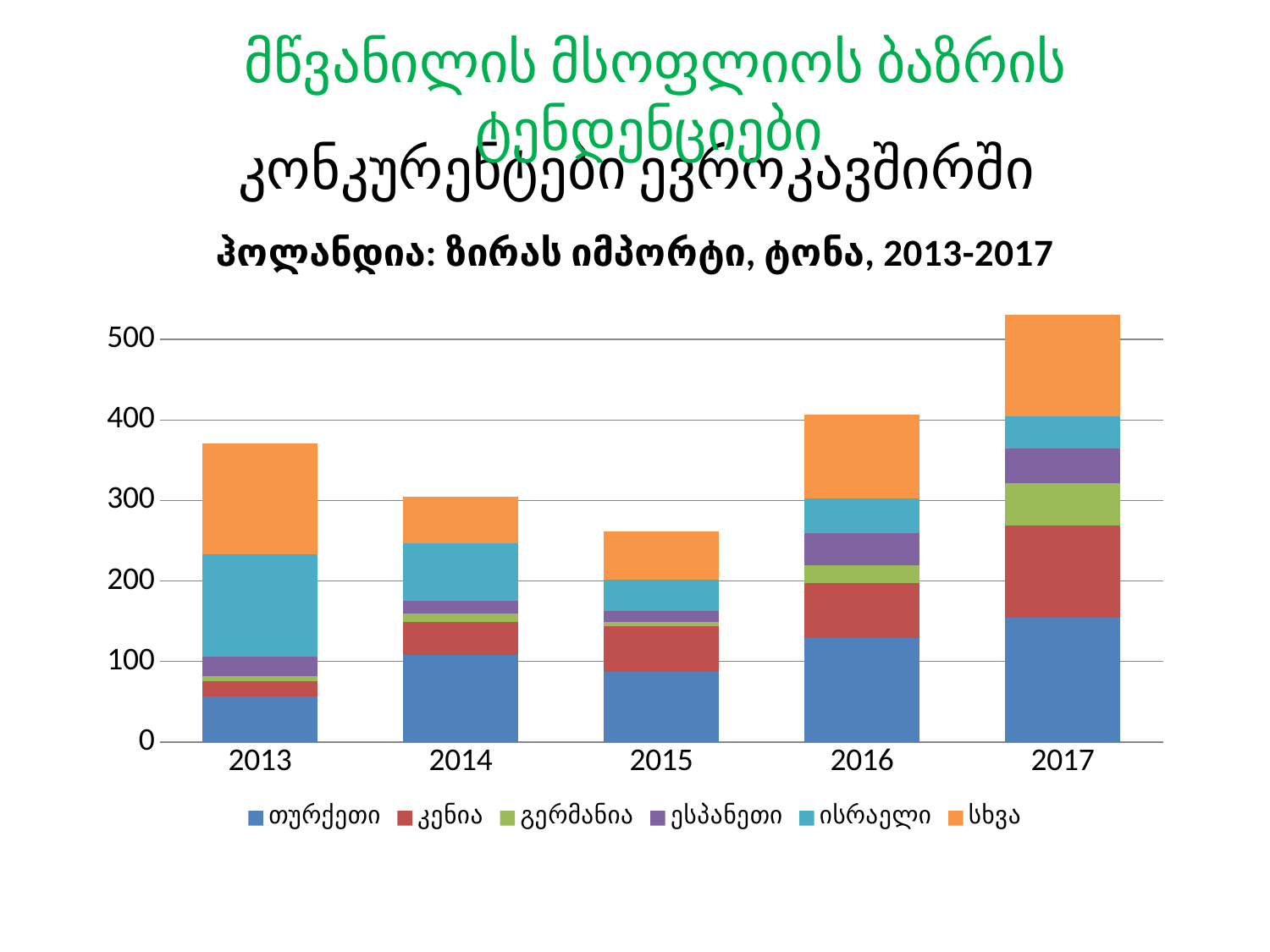
What kind of chart is shown on the slide? stacked bar chart Which series is listed first in the chart's legend? თურქეთი How many years are shown on the x axis of the chart? 5 Is the total for 2015 greater or less than 300? less Is the total for 2017 greater or less than 500? greater Is the total for 2014 greater or less than 400? less How many series does the chart's legend list? 6 Which year has the highest total stacked bar? 2017 Do the total bar heights rise or fall from 2015 to 2017? rise Which year has a larger total bar, 2016 or 2014? 2016 Which year has the lowest total stacked bar? 2015